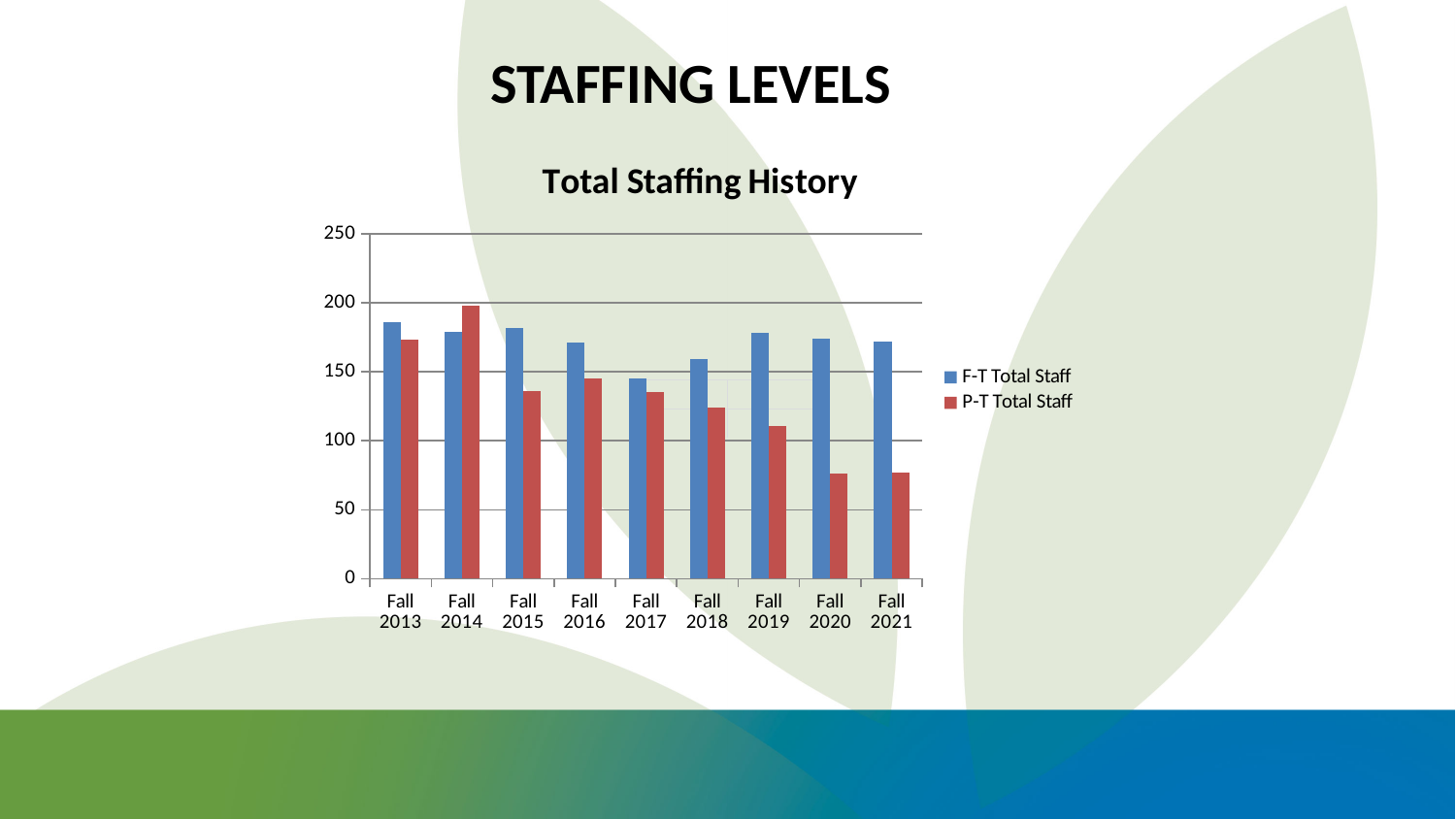
Is the value for P-T Total Staff in Fall 2020 greater or less than 100? less In Fall 2014, which is larger: F-T Total Staff or P-T Total Staff? P-T Total Staff What is the title of the chart? Total Staffing History In which Fall term is F-T Total Staff lowest? Fall 2017 Which series is shown in red? P-T Total Staff In which Fall term is P-T Total Staff highest? Fall 2014 Is the value for F-T Total Staff in Fall 2013 greater or less than 150? greater What kind of chart is shown on the slide? Bar chart Does P-T Total Staff generally rise or fall from Fall 2014 to Fall 2021? Fall How many series does the legend list? 2 How many Fall terms are shown on the x axis? 9 Is the value for P-T Total Staff in Fall 2018 greater or less than 150? less